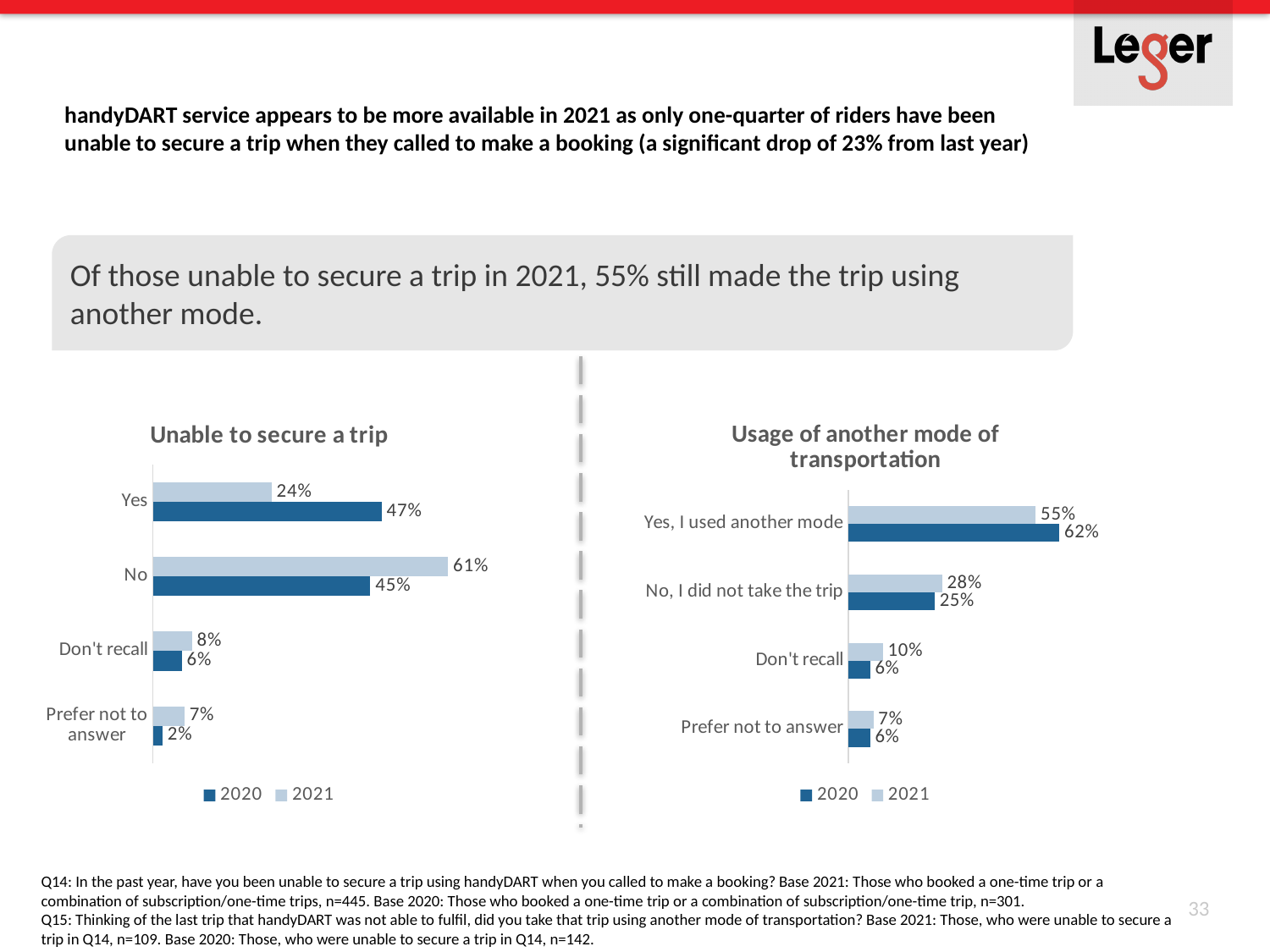
In the 'Usage of another mode of transportation' chart, which is larger for 'Don't recall': the 2020 value or the 2021 value? 2021 In the 'Unable to secure a trip' chart, how many categories are shown? 4 How many series does the legend of the 'Usage of another mode of transportation' chart list? 2 In the 'Unable to secure a trip' chart, what is the difference between the 2020 and 2021 values for 'Yes'? 23% In the 'Unable to secure a trip' chart, what is the 2020 value for 'No'? 45% In the 'Unable to secure a trip' chart, which category has the highest 2021 value? No In the 'Usage of another mode of transportation' chart, what is the difference between the 2020 and 2021 values for 'Yes, I used another mode'? 7% What type of chart is the 'Unable to secure a trip' chart? Bar chart In the 'Unable to secure a trip' chart, which category has the lowest 2020 value? Prefer not to answer In the 'Usage of another mode of transportation' chart, what is the 2020 value for 'Yes, I used another mode'? 62% In the 'Unable to secure a trip' chart, what is the 2021 value for 'Yes'? 24% In the 'Usage of another mode of transportation' chart, what is the 2021 value for 'No, I did not take the trip'? 28%